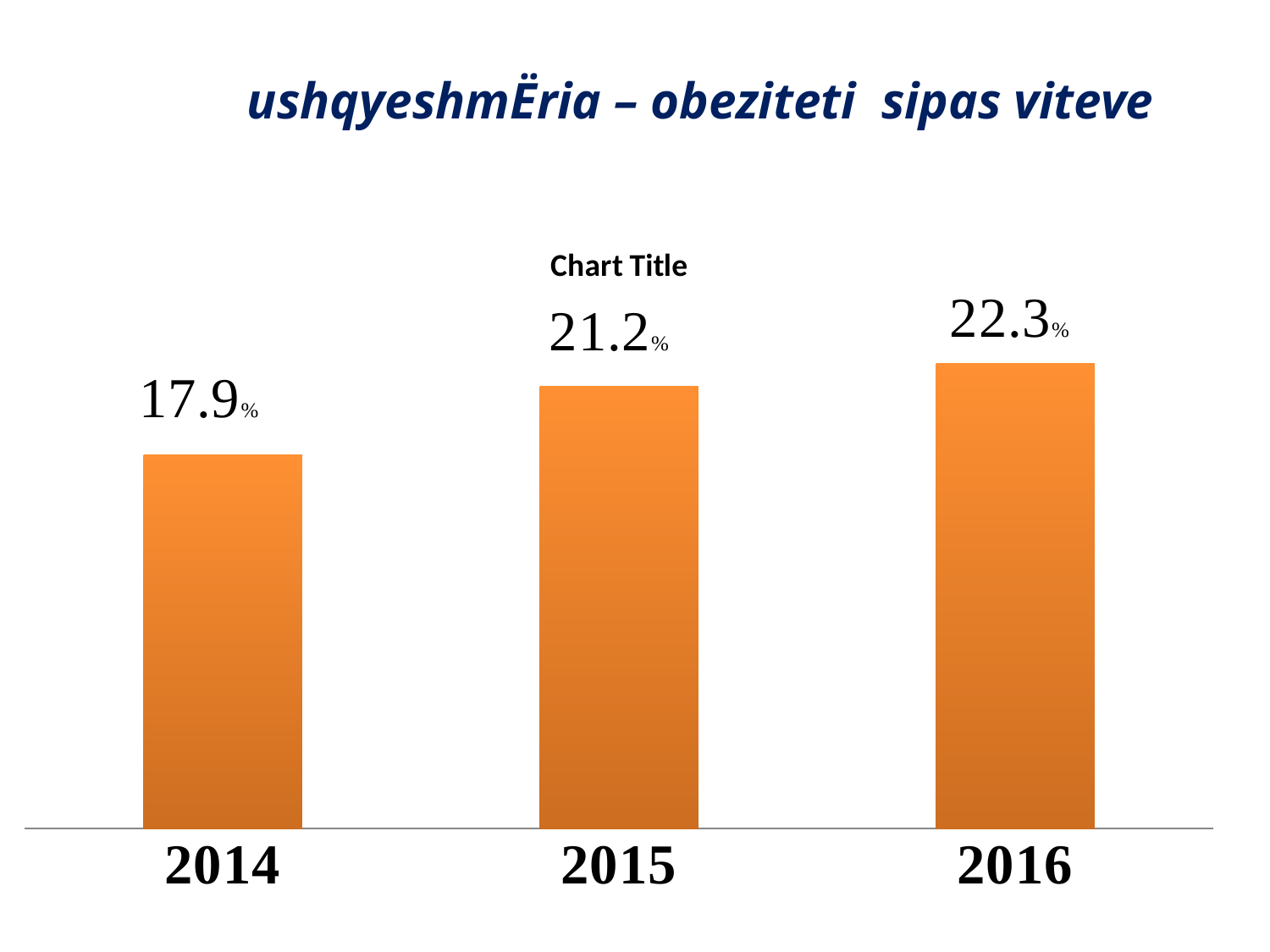
What is the value for 2014? 17.9% Which is larger, the value for 2015 or the value for 2014? 2015 What is the value for 2016? 22.3% Do the values rise or fall from 2014 to 2016? Rise What kind of chart is shown on the slide? Bar chart Which year has the lowest value? 2014 What colour are the bars in the chart? Orange What is the value for 2015? 21.2% How many years are shown on the chart? 3 Which year has the highest value? 2016 What is the difference between the values for 2015 and 2014? 3.3% What is the difference between the values for 2016 and 2014? 4.4%